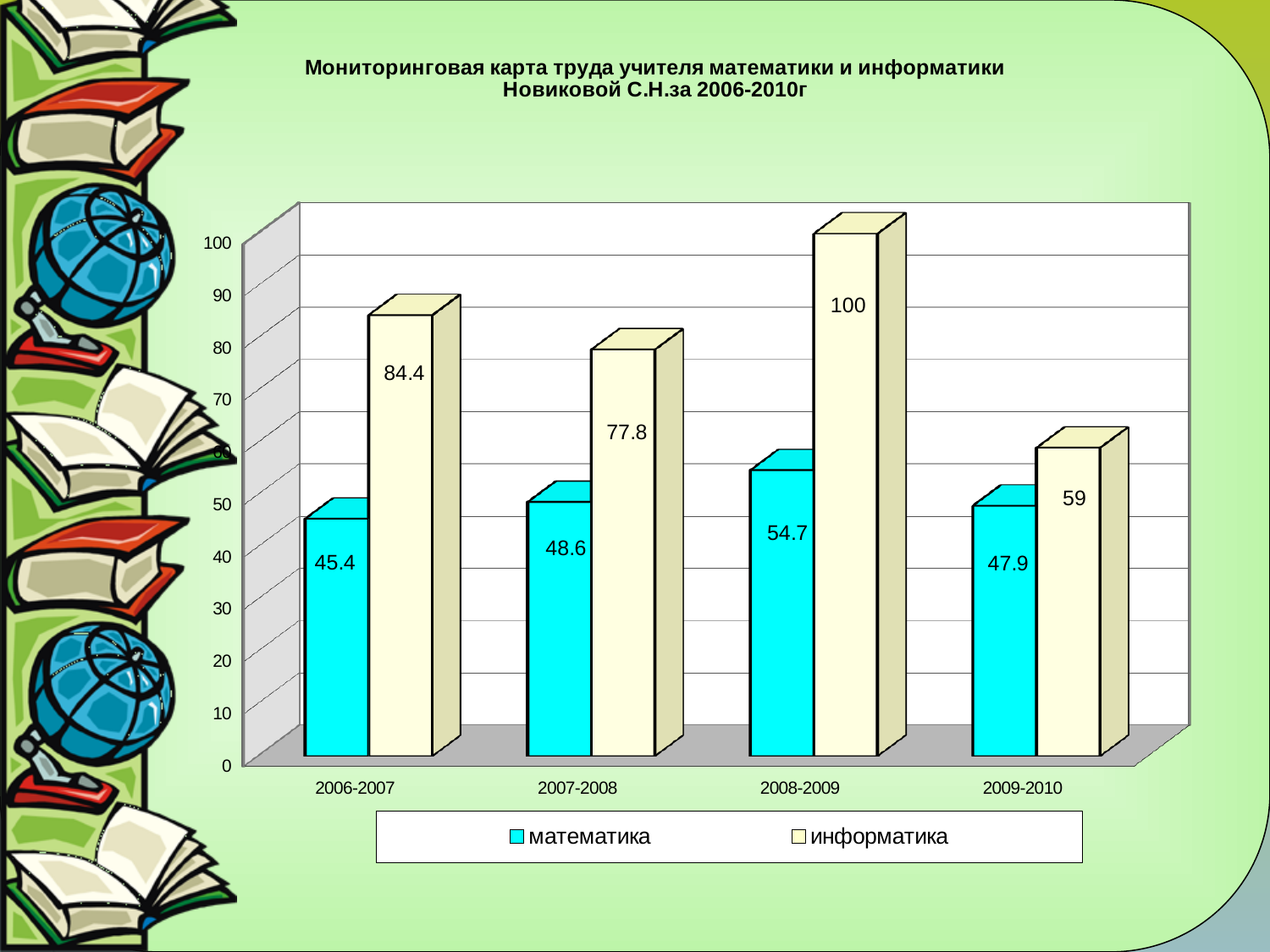
What is the value for информатика in 2008-2009? 100 Is the value for информатика in 2006-2007 greater or less than 80? greater What is the difference between the информатика and математика values in 2007-2008? 29.2 Which series is shown in cyan according to the legend? математика What kind of chart is shown on the slide? bar chart What is the value for математика in 2006-2007? 45.4 In which year is the математика value highest? 2008-2009 In which year is the информатика value lowest? 2009-2010 Which is larger in 2009-2010, математика or информатика? информатика What is the value for информатика in 2009-2010? 59 How many series does the legend list? 2 How many year categories are shown on the x axis? 4